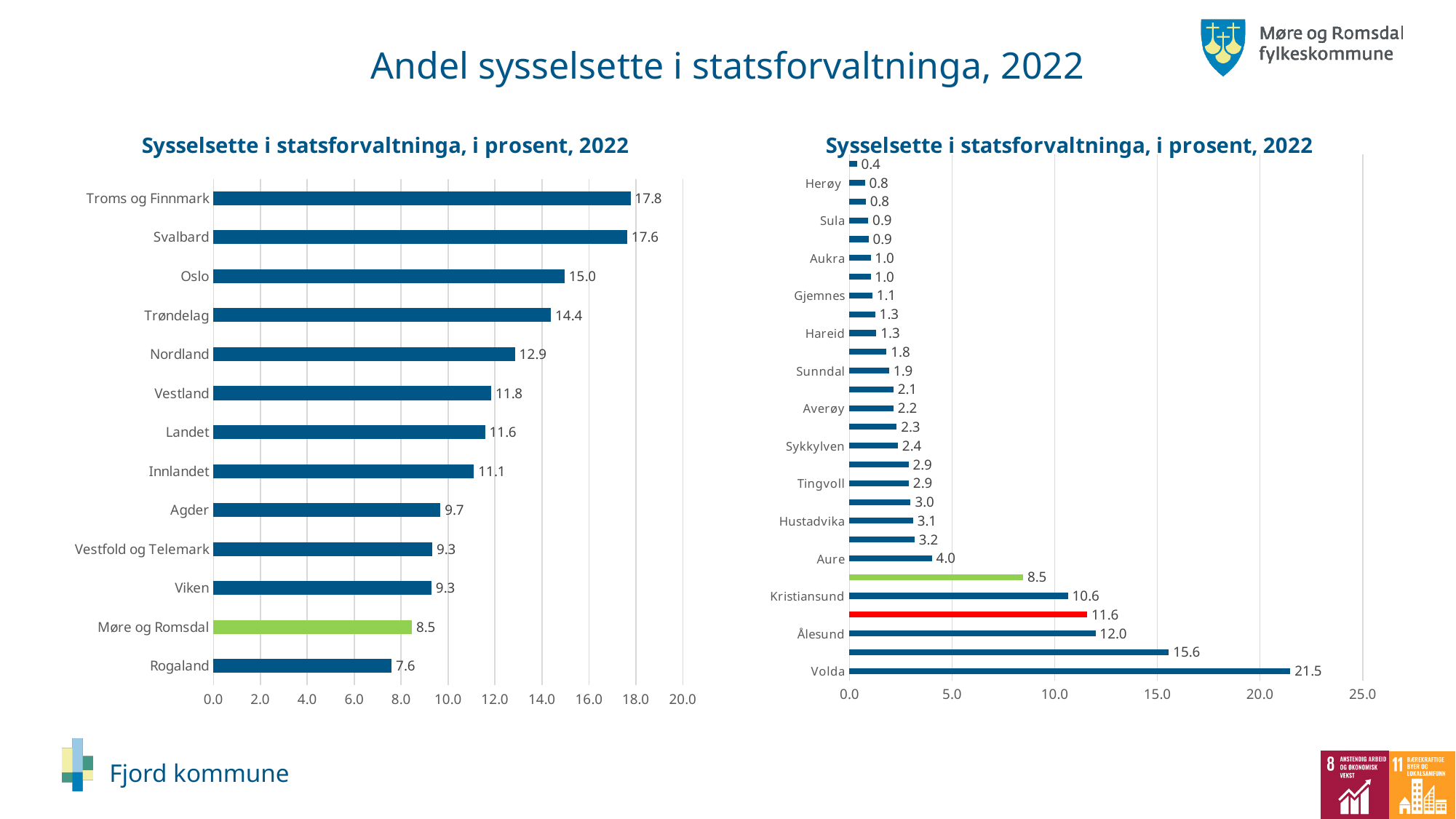
How many categories are shown in the left chart? 13 In the right chart, what is the value for Kristiansund? 10.6 In the right chart, what is the value for Volda? 21.5 In the left chart, which category has the highest value? Troms og Finnmark In the left chart, what is the value for Troms og Finnmark? 17.8 In the left chart, what is the value for Møre og Romsdal? 8.5 In the left chart, which bar is coloured green? Møre og Romsdal In the left chart, which is larger, Nordland or Vestland? Nordland What kind of chart is the left chart? Bar chart In the left chart, which category has the lowest value? Rogaland In the left chart, what is the difference between Oslo and Landet? 3.4 In the right chart, what is the difference between Ålesund and Aure? 8.0